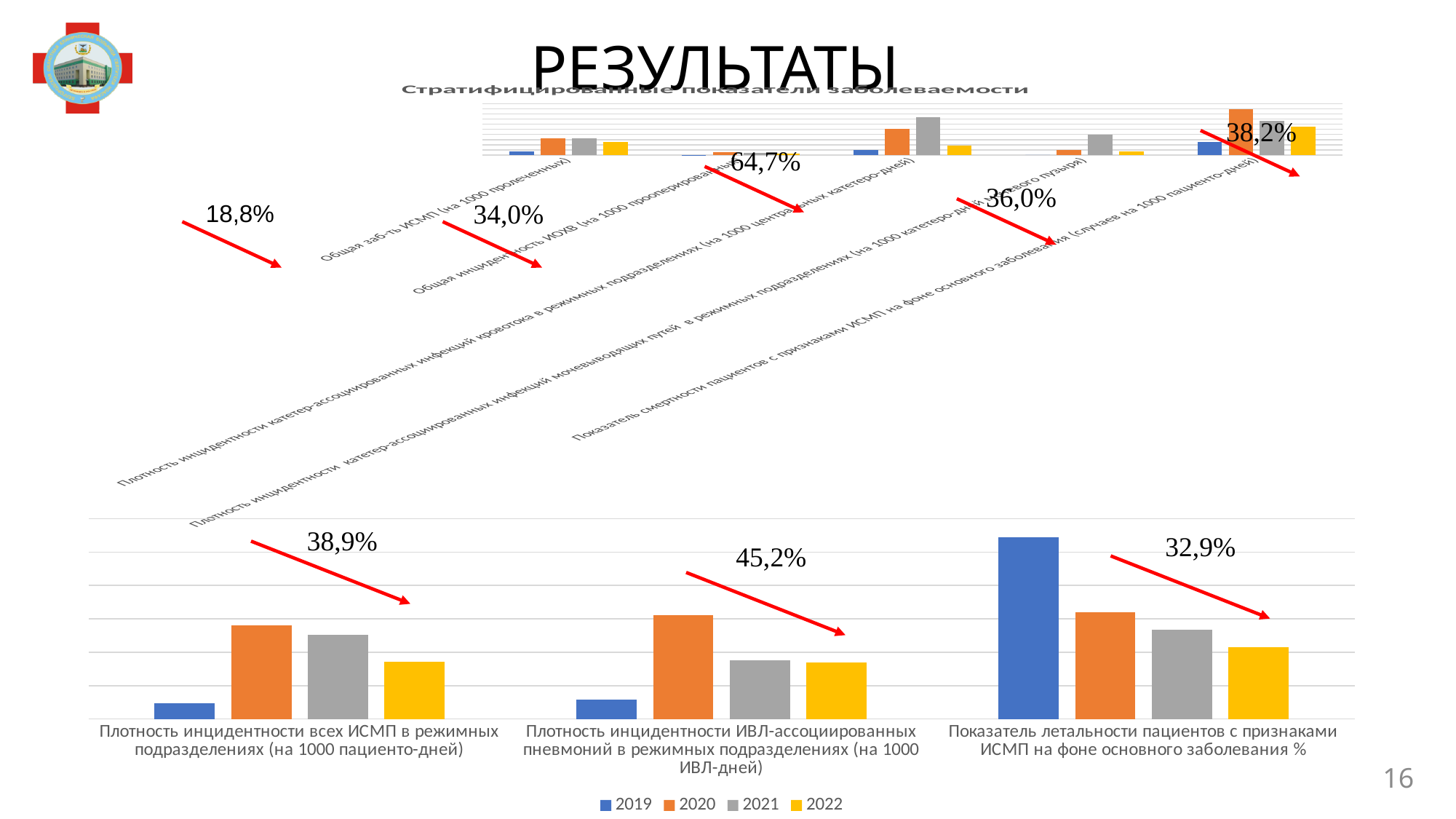
In the bottom chart, for 'Показатель летальности пациентов с признаками ИСМП на фоне основного заболевания %', do the bars rise or fall from 2019 to 2022? Fall In the bottom chart, which year has the highest bar for 'Показатель летальности пациентов с признаками ИСМП на фоне основного заболевания %'? 2019 What is the title of the top chart on the slide? Стратифицированные показатели заболеваемости In the bottom chart, which year has the highest bar for 'Плотность инцидентности всех ИСМП в режимных подразделениях (на 1000 пациенто-дней)'? 2020 How many category groups of bars are shown in the top chart 'Стратифицированные показатели заболеваемости'? 5 What kind of chart is the bottom chart on the slide? Bar chart How many series does the legend of the bottom chart list? 4 In the bottom chart, for 'Плотность инцидентности ИВЛ-ассоциированных пневмоний в режимных подразделениях (на 1000 ИВЛ-дней)', which is larger: the 2020 bar or the 2022 bar? 2020 Which years are listed in the legend of the bottom chart? 2019, 2020, 2021, 2022 In the bottom chart, which year has the lowest bar for 'Показатель летальности пациентов с признаками ИСМП на фоне основного заболевания %'? 2022 In the bottom chart, which year has the lowest bar for 'Плотность инцидентности всех ИСМП в режимных подразделениях (на 1000 пациенто-дней)'? 2019 How many categories are shown on the x axis of the bottom chart? 3